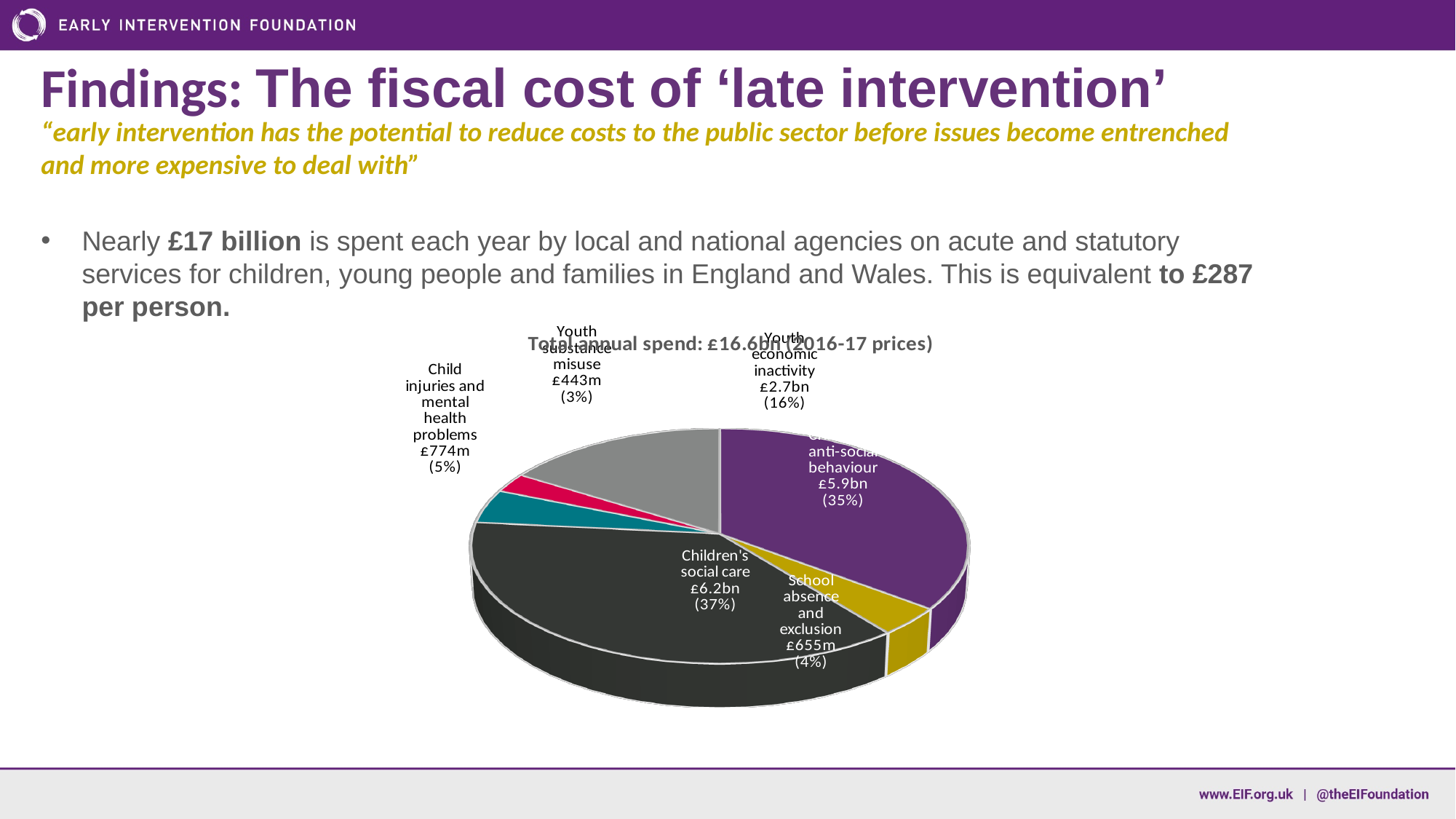
Which category has the smallest slice of the pie chart? Youth substance misuse What is the spend on school absence and exclusion? £655m What share of the pie does children's social care represent? 37% Which is larger: the spend on child injuries and mental health problems or on school absence and exclusion? Child injuries and mental health problems Which category has the largest slice of the pie chart? Children's social care What is the annual spend on children's social care shown in the pie chart? £6.2bn How many slices does the pie chart have? 6 What total annual spend is stated in the pie chart's title? £16.6bn What percentage of the pie is youth substance misuse? 3% What kind of chart is shown on the slide? Pie chart What is the difference in percentage share between children's social care and youth economic inactivity? 21% What is the annual spend on youth economic inactivity? £2.7bn